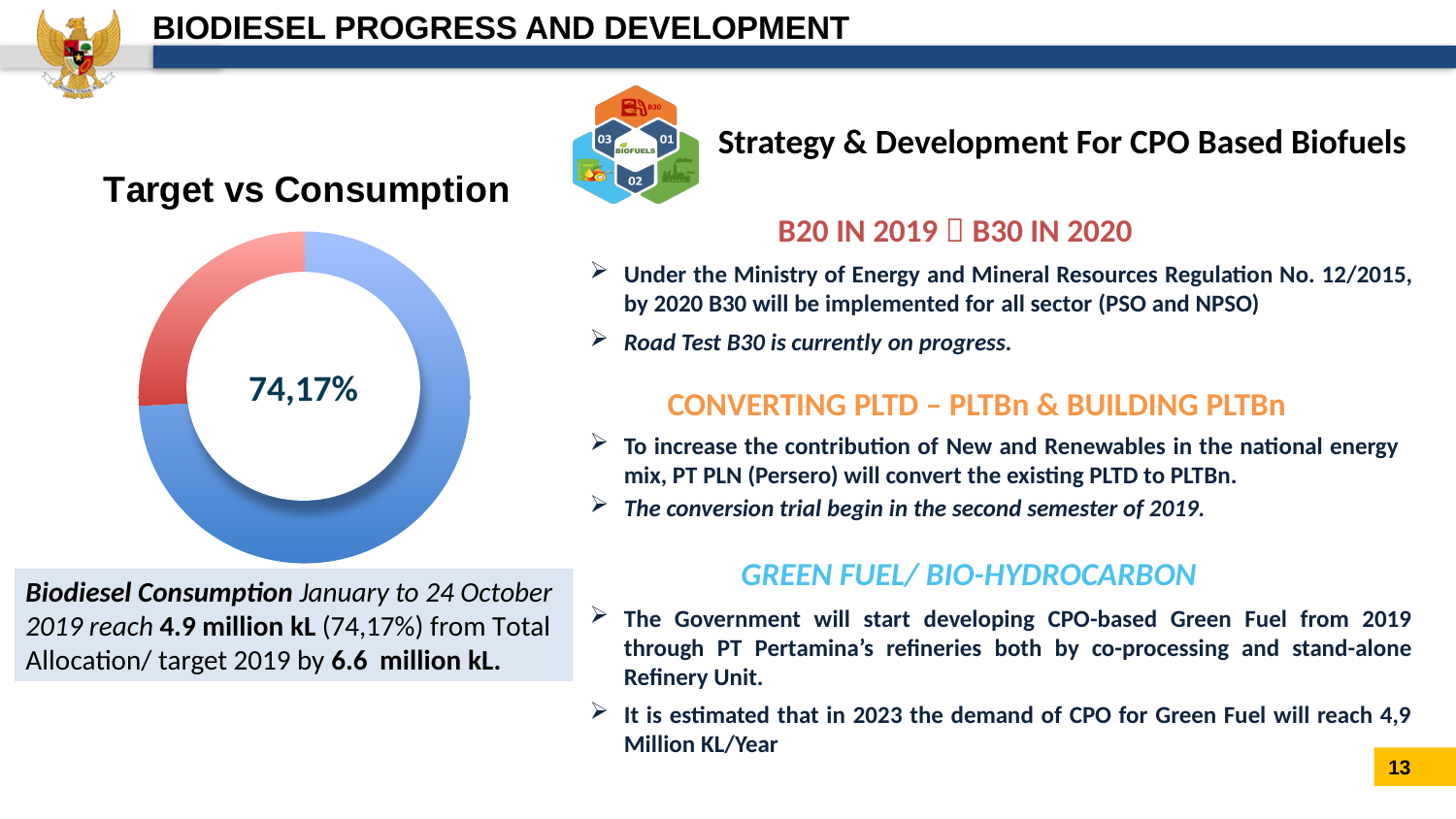
In the Target vs Consumption chart, which slice is larger, the blue one or the red one? The blue one What kind of chart is shown under the title "Target vs Consumption"? Doughnut (pie) chart What percentage value is printed in the centre of the Target vs Consumption chart? 74,17% According to the text below the chart, what biodiesel consumption does the 74,17% share correspond to? 4.9 million kL What is the title of the chart on the left side of the slide? Target vs Consumption According to the text below the chart, what is the total allocation/target for 2019? 6.6 million kL How many slices does the Target vs Consumption doughnut chart have? 2 Is the share of the blue slice in the Target vs Consumption chart greater or less than 50%? greater What colour is the larger slice of the Target vs Consumption chart? Blue